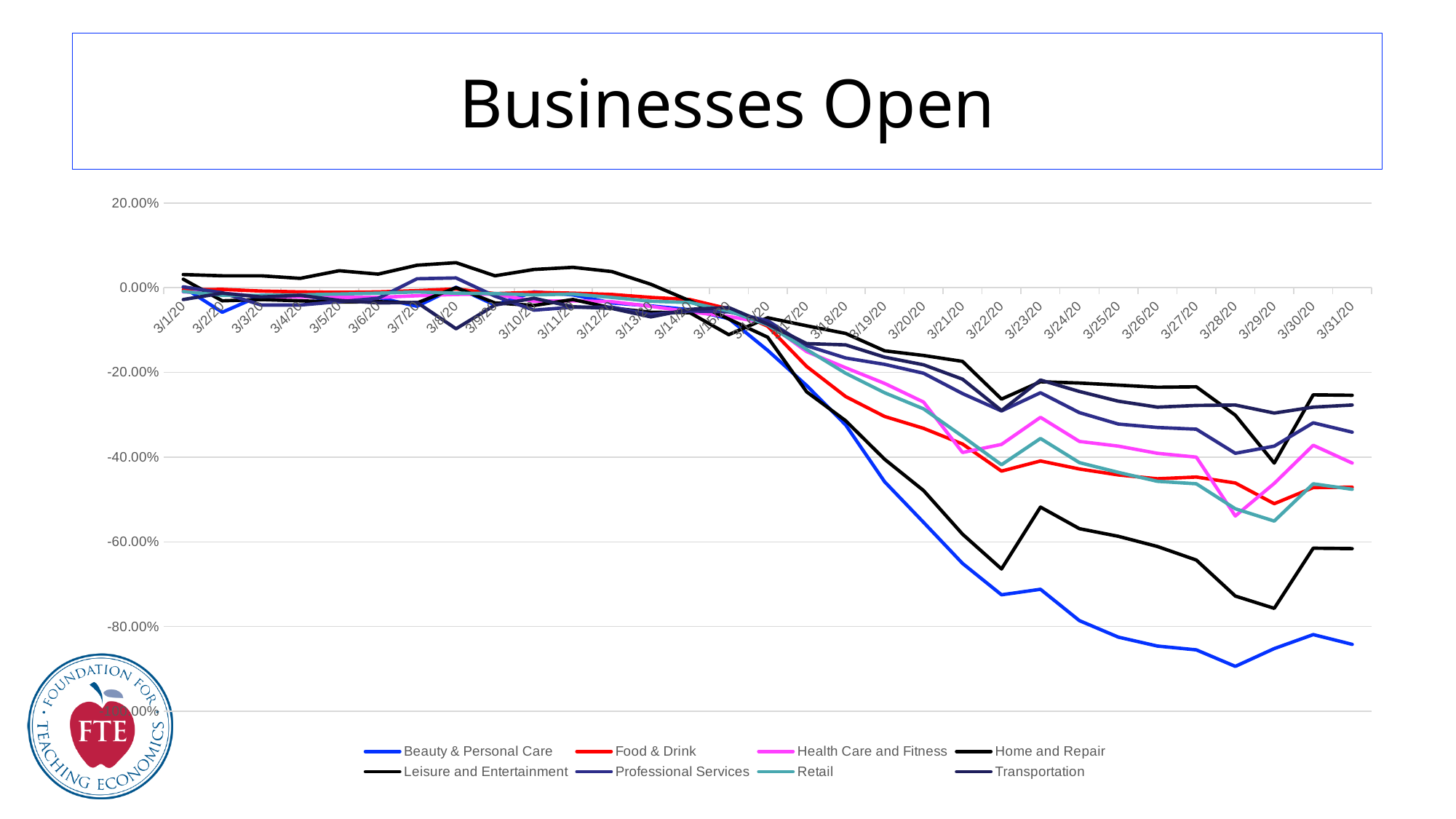
Which series has the lowest value on 3/31/20? Beauty & Personal Care What is the title of the chart? Businesses Open Is the value for Health Care and Fitness on 3/28/20 greater or less than -40.00%? less What colour is the line for Beauty & Personal Care? blue How many dates are plotted along the x axis? 31 Is the value for Food & Drink on 3/31/20 greater or less than -40.00%? less What kind of chart is shown on the slide? line chart How many series does the legend list? 8 Is the value for Beauty & Personal Care on 3/31/20 greater or less than -80.00%? less Do the values generally rise or fall from 3/1/20 to 3/31/20? fall On 3/31/20, which is larger: the value for Home and Repair or the value for Beauty & Personal Care? Home and Repair